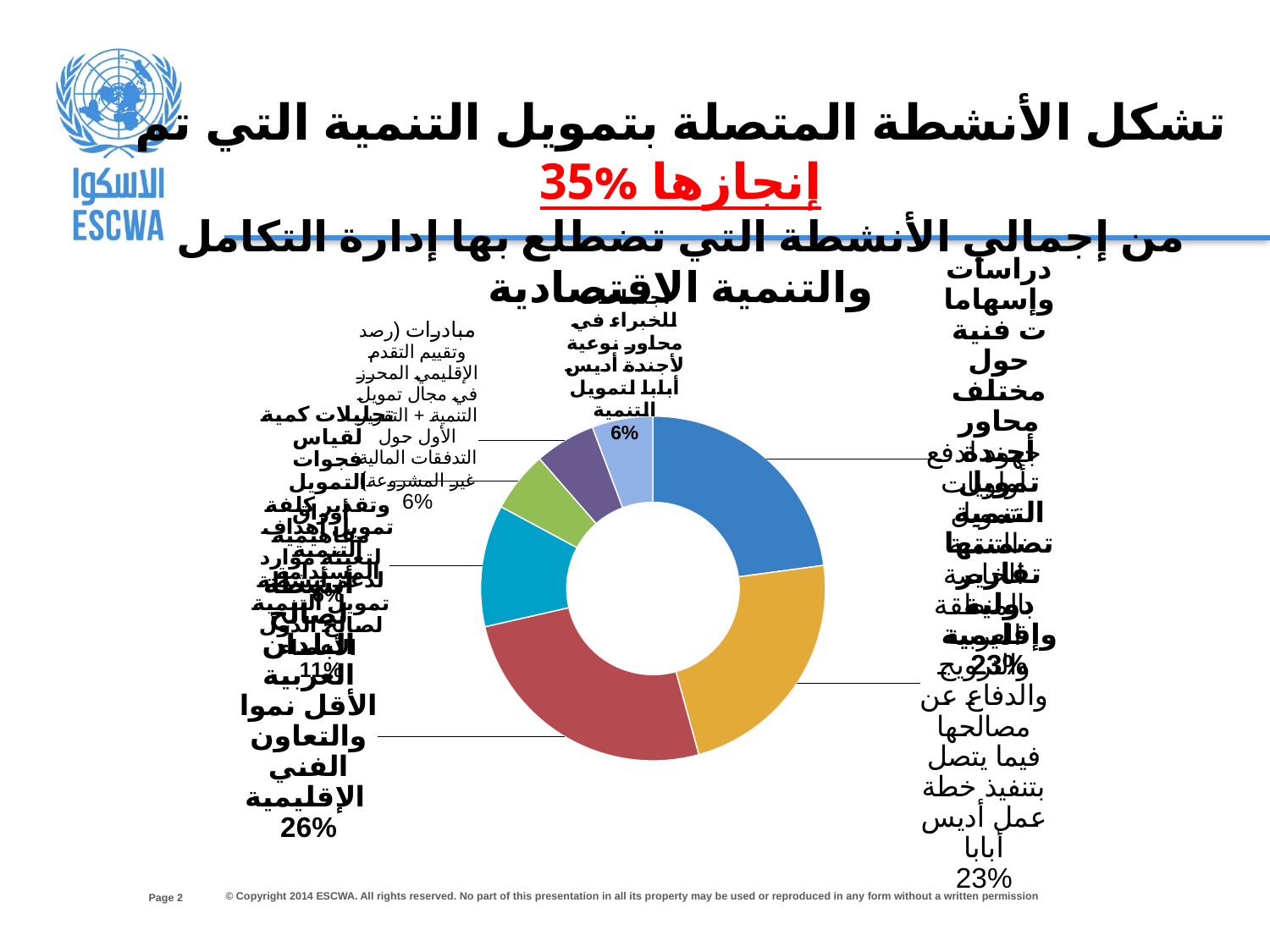
What percentage is shown for the red slice of the donut chart? 26% Which slice is larger, the blue slice on the right or the light blue slice at the top? the blue slice on the right Is the share of the red slice greater or less than 25%? greater What percentage is shown for the light blue slice at the top of the donut chart (labelled للخبراء في محاور نوعية لأجندة أديس أبابا لتمويل التنمية)? 6% What kind of chart is shown on the slide? pie chart (donut) What percentage is highlighted in red in the slide title? 35% What is the largest percentage shown on the donut chart? 26% How many slices does the donut chart have? 7 What percentage is shown for the orange slice of the donut chart? 23% Which slice is larger, the red slice or the orange slice? the red slice What is the difference in percentage points between the red slice (26%) and the orange slice (23%)? 3 percentage points What percentage is shown for the large blue slice on the right of the donut chart? 23%